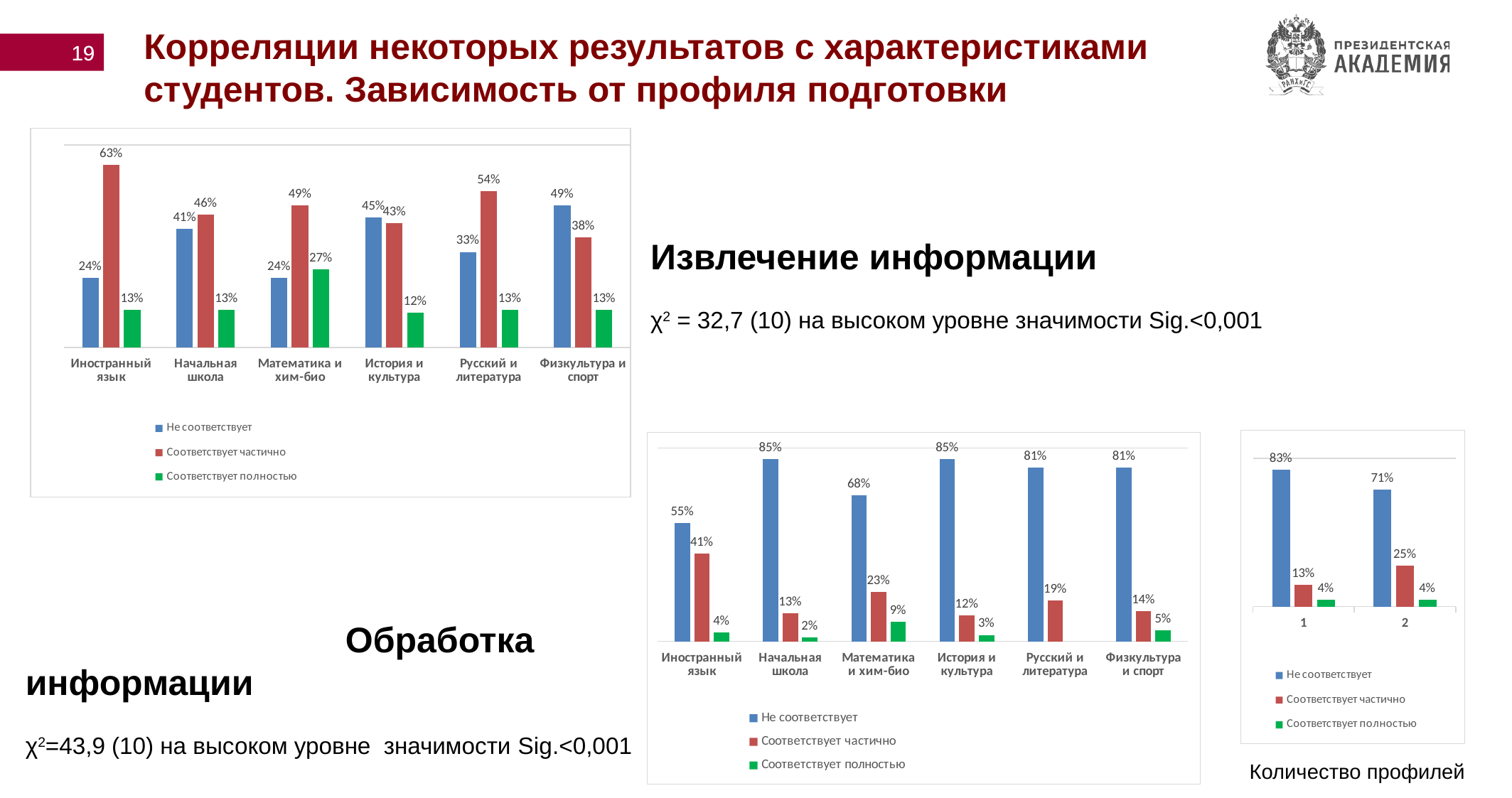
In the top-left chart, how many categories are shown on the x axis? 6 In the top-left chart, what colour represents 'Соответствует полностью'? Green In the top-left chart, which category has the highest 'Не соответствует' value? Физкультура и спорт In the bottom-middle chart, what is the value of 'Не соответствует' for 'Математика и хим-био'? 68% In the top-left chart, what is the value of 'Соответствует частично' for 'Иностранный язык'? 63% In the bottom-middle chart, how many series does the legend list? 3 In the bottom-right chart, what is the value of 'Не соответствует' for category '2'? 71% What type of chart is the bottom-right chart? Bar chart In the bottom-right chart, what is the difference between 'Соответствует частично' for category '2' and category '1'? 12% In the bottom-middle chart, which category has the lowest 'Соответствует полностью' value? Начальная школа In the top-left chart, what is the difference between 'Соответствует частично' and 'Не соответствует' for 'Русский и литература'? 21% In the bottom-middle chart, which is larger: 'Соответствует частично' for 'Иностранный язык' or for 'Математика и хим-био'? Иностранный язык